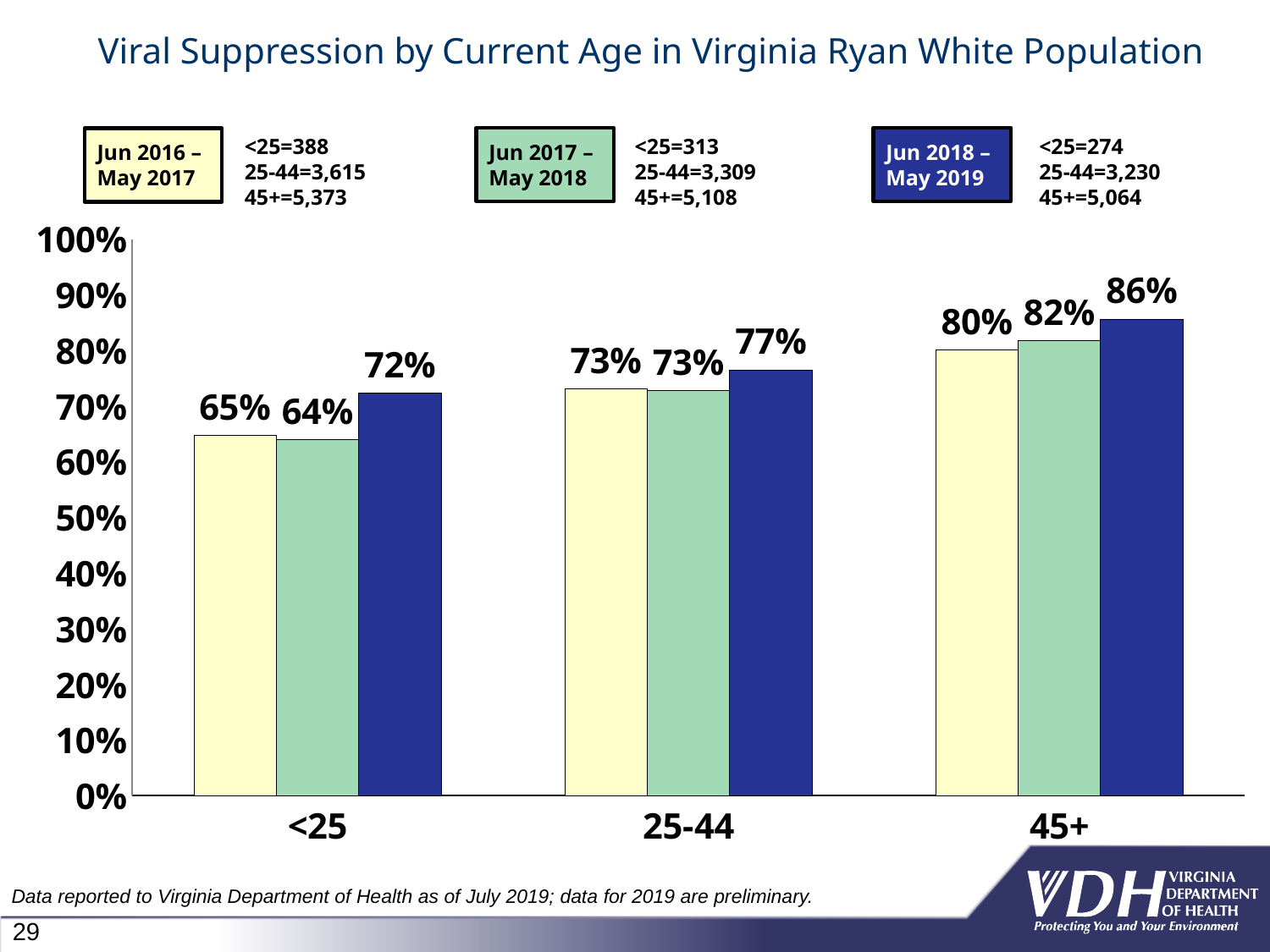
Which colour represents the Jun 2018 – May 2019 period? Dark blue What is the viral suppression percentage for the <25 age group in Jun 2018 – May 2019? 72% How many time periods (series) does the legend list? 3 Which age group has the highest viral suppression percentage in Jun 2018 – May 2019? 45+ What is the viral suppression percentage for the 25-44 age group in Jun 2017 – May 2018? 73% What is the viral suppression percentage for the 45+ age group in Jun 2016 – May 2017? 80% What kind of chart is shown on the slide? Bar chart What is the difference between the 45+ and <25 viral suppression percentages in Jun 2018 – May 2019? 14% Do the Jun 2018 – May 2019 viral suppression values rise or fall as age group increases from <25 to 45+? Rise Which age group has the lowest viral suppression percentage in Jun 2017 – May 2018? <25 How many age groups are shown on the x axis? 3 Which is larger for the <25 age group: the Jun 2016 – May 2017 value or the Jun 2017 – May 2018 value? Jun 2016 – May 2017